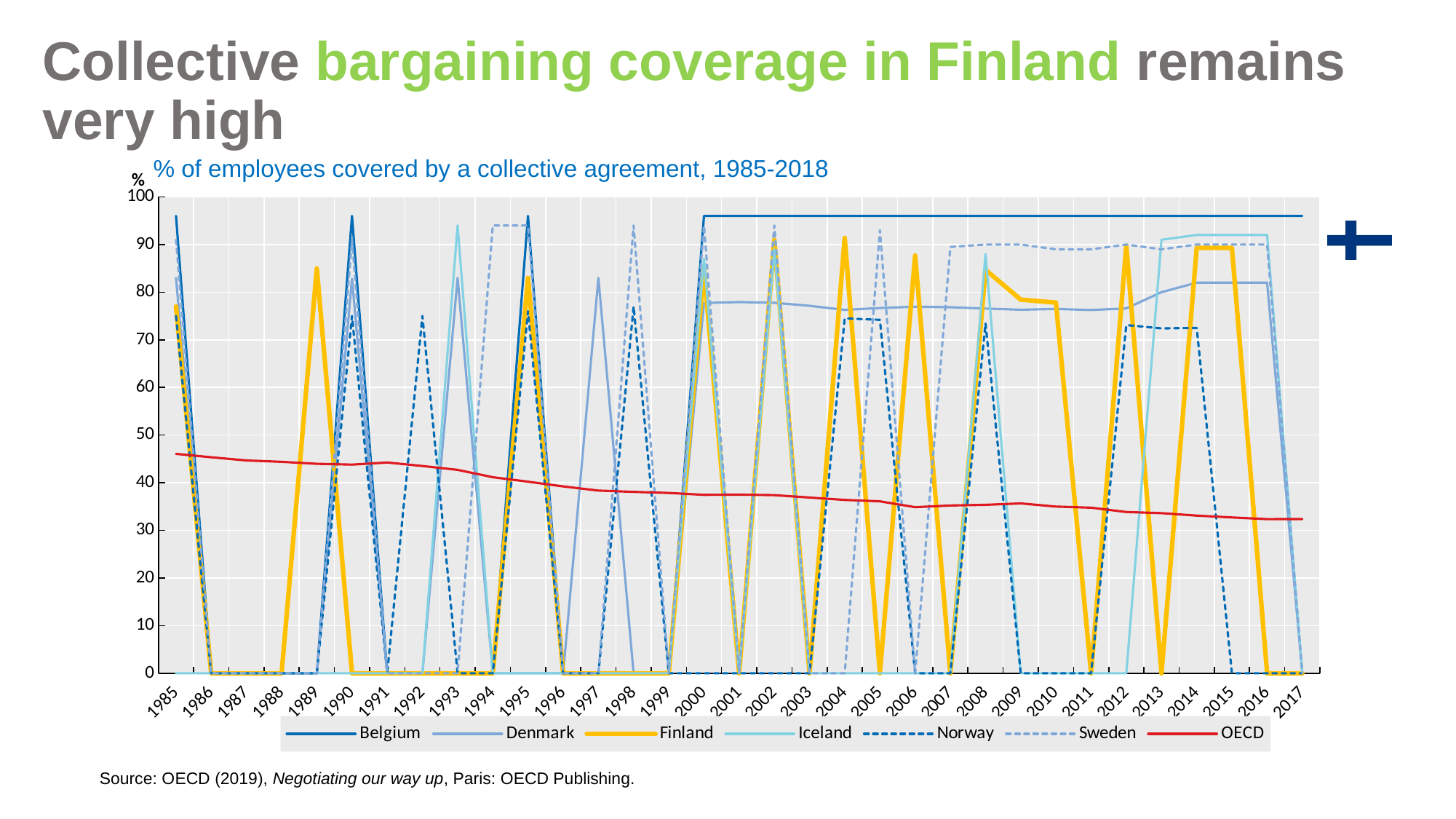
Which series has the highest value in 2017? Belgium What kind of chart is shown on the slide? line chart Which is larger in 2014, the value for Finland or the value for Denmark? Finland Is the value for Belgium in 2010 greater or less than 90? greater How many years are labelled on the x axis? 33 Which series is drawn in red? OECD Is the OECD value in 1985 greater or less than 40? greater Is the OECD value in 2017 greater or less than 40? less What is the subtitle of the chart? % of employees covered by a collective agreement, 1985-2018 How many series does the legend list? 7 Does the OECD line rise or fall from 1985 to 2017? fall